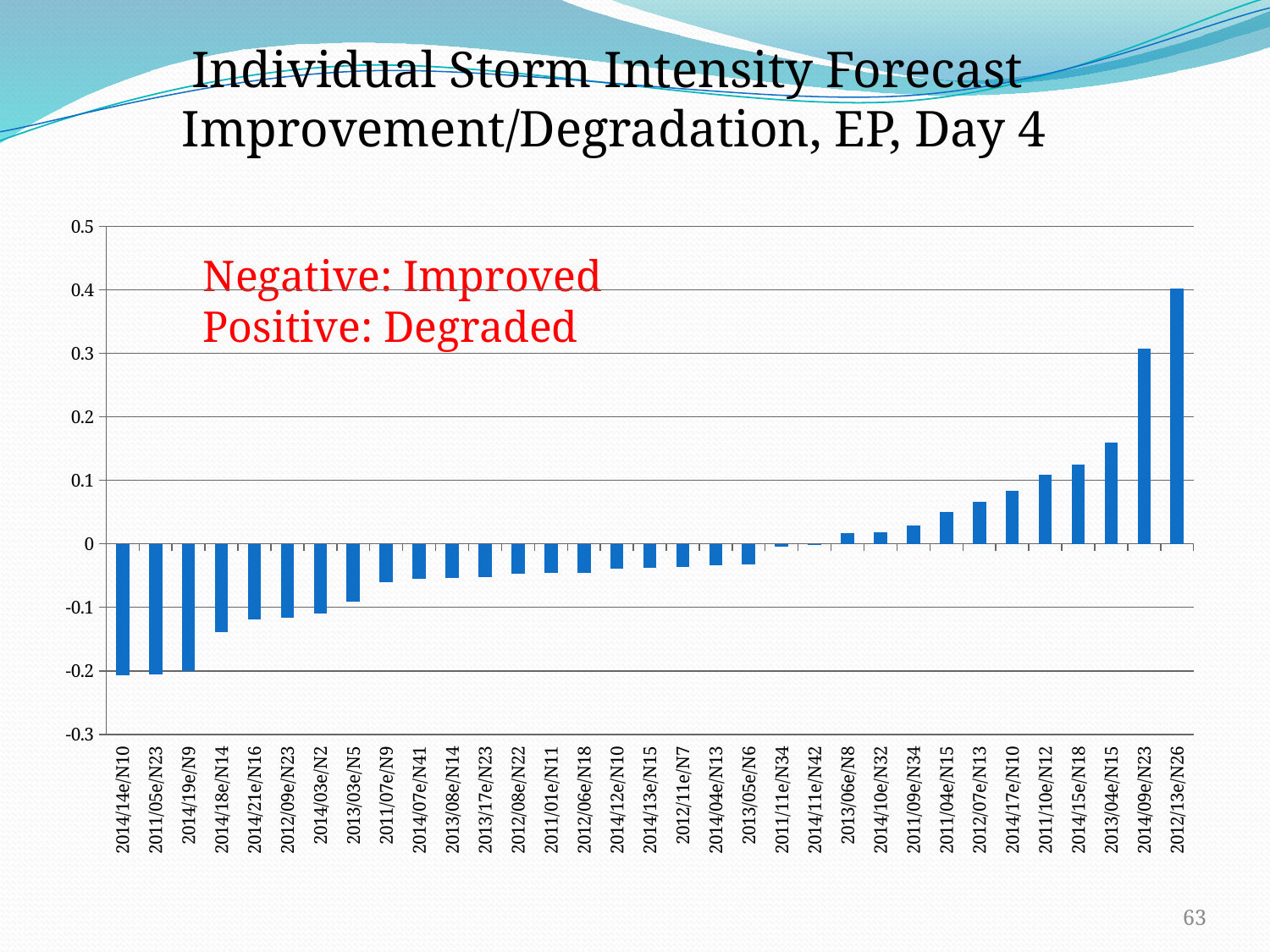
Is the value for 2012/13e/N26 greater or less than 0.3? greater Is the value for 2014/09e/N23 greater or less than 0.2? greater Is the value for 2013/04e/N15 greater or less than 0.1? greater Which has the larger value, 2012/13e/N26 or 2014/09e/N23? 2012/13e/N26 What kind of chart is shown on the slide? Bar chart According to the red annotation on the chart, what does a negative value indicate? Improved How many storms (categories) are plotted along the x axis? 33 Do the values rise or fall moving from left to right along the x axis? Rise Which storm has the highest value on the chart? 2012/13e/N26